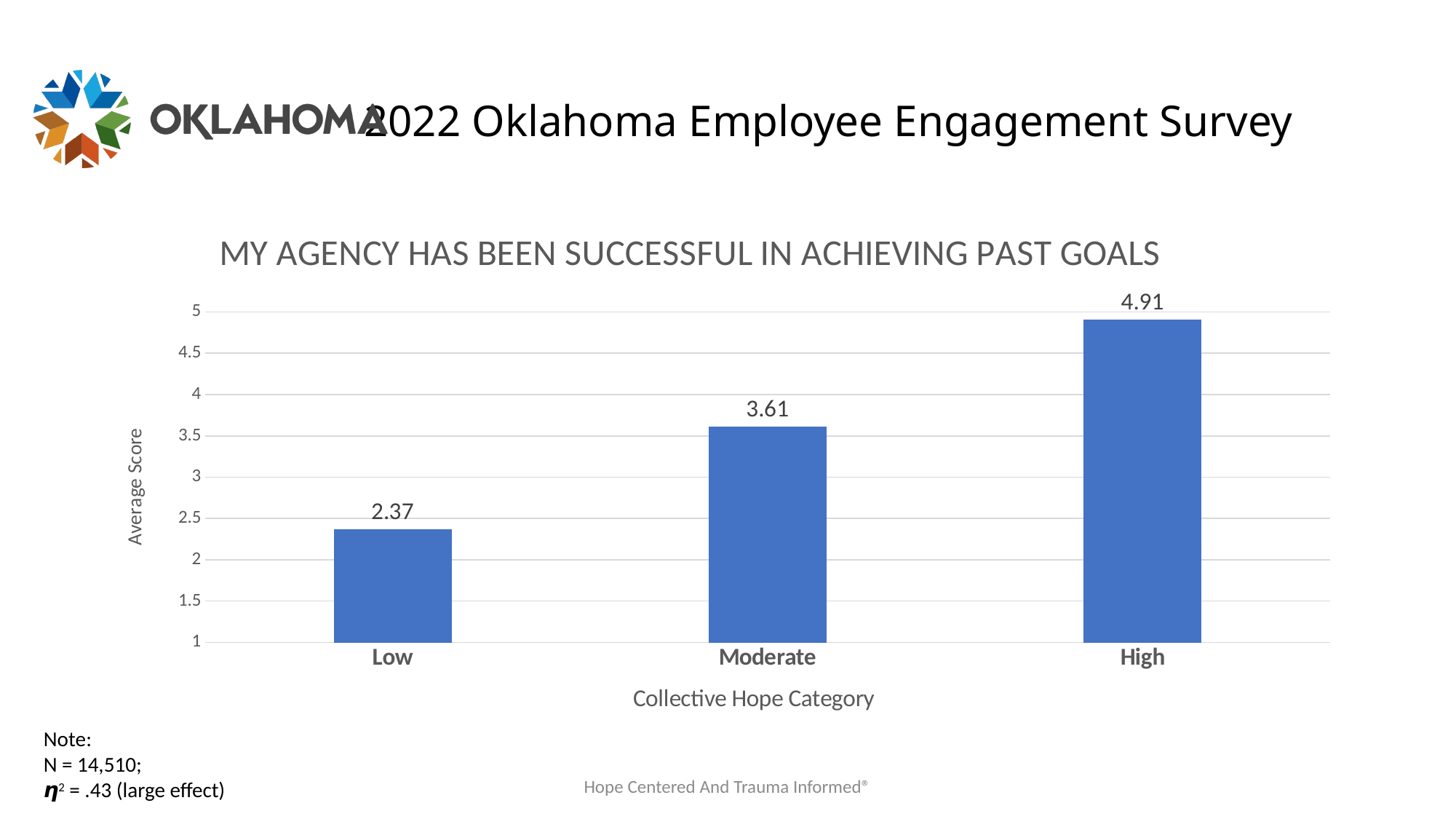
What is the difference in average score between the Moderate and Low categories? 1.24 What is the average score for the Low collective hope category? 2.37 What kind of chart is shown on the slide? Bar chart Is the average score for the Moderate category greater or less than 3.5? greater Which collective hope category has the lowest average score? Low Do the average scores rise or fall from Low to High along the x axis? Rise What is the average score for the Moderate collective hope category? 3.61 Which collective hope category has the highest average score? High Which has a higher average score, Moderate or High? High What is the difference in average score between the High and Low categories? 2.54 How many collective hope categories are shown on the chart? 3 What is the average score for the High collective hope category? 4.91